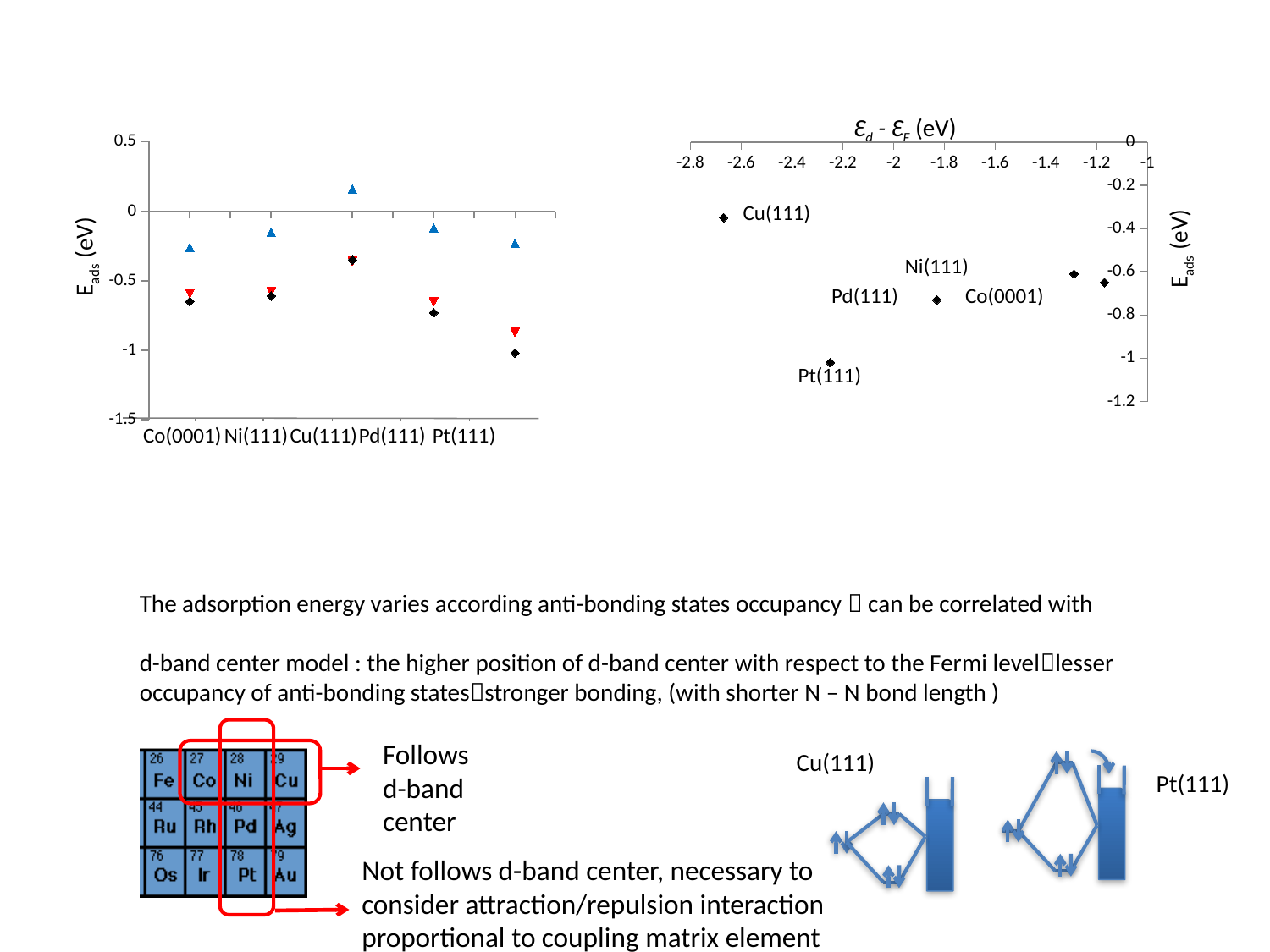
In the left chart, is the black diamond value for Co(0001) greater or less than -0.5? less In the right chart (E_ads vs ε_d - ε_F), which labelled point has the highest E_ads? Cu(111) In the right chart, is the E_ads value for Pt(111) greater or less than -0.8? less In the left chart, which has the higher black diamond value, Cu(111) or Pt(111)? Cu(111) In the left chart, is the red triangle value for Pt(111) greater or less than -0.5? less What kind of chart is the left chart on the slide? scatter chart In the right chart (E_ads vs ε_d - ε_F), which labelled point has the lowest E_ads? Pt(111) What is the y-axis label of the right chart? E_ads (eV) In the left chart, which category has the lowest black diamond value? Pt(111) How many categories are shown on the x axis of the left chart? 5 In the left chart, which category has a blue triangle marker above 0 eV? Cu(111)